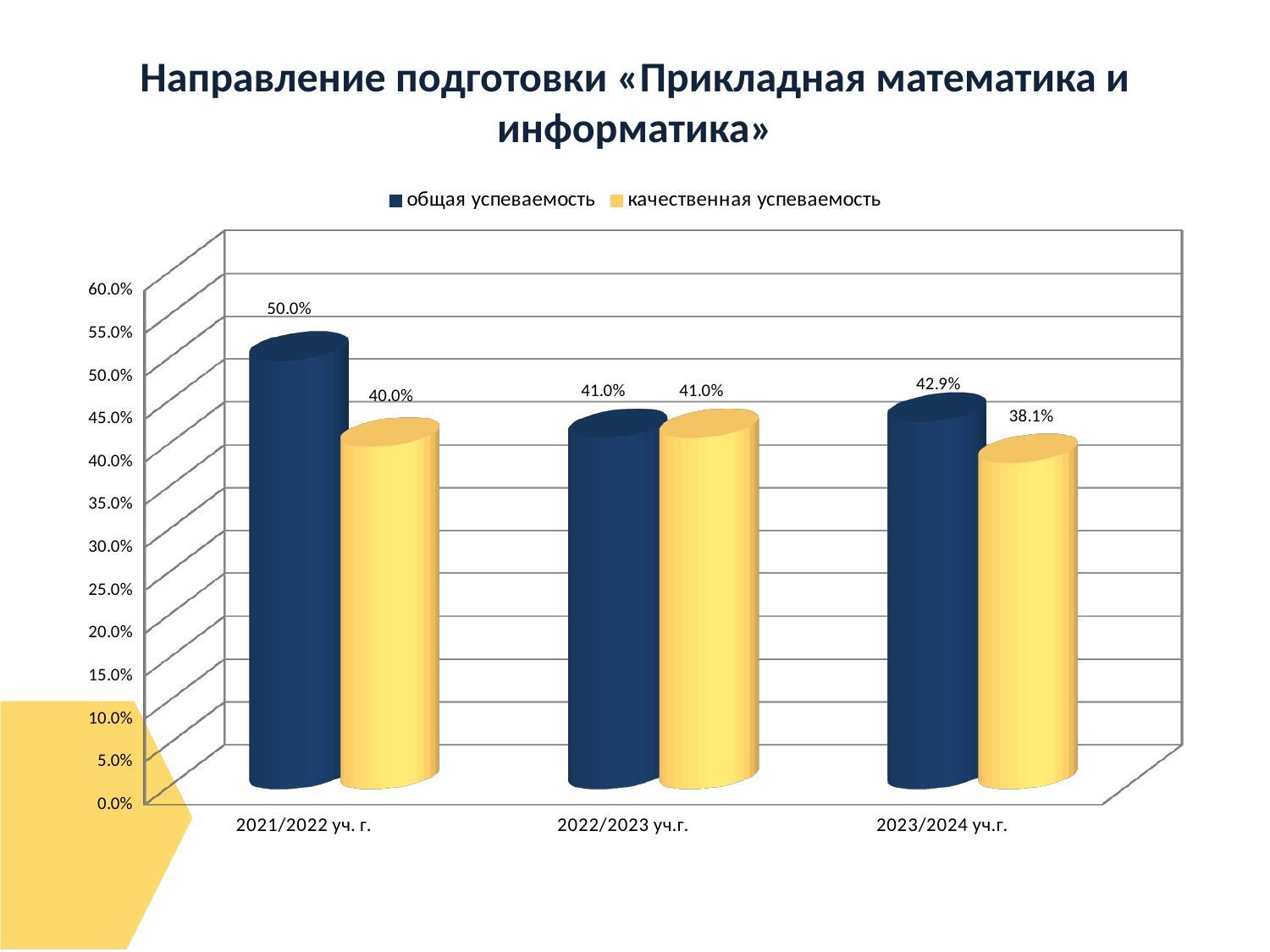
What is the value of общая успеваемость for 2023/2024 уч.г.? 42.9% What is the value of качественная успеваемость for 2023/2024 уч.г.? 38.1% What is the value of общая успеваемость for 2021/2022 уч. г.? 50.0% How many academic years are shown on the x axis? 3 In which academic year is общая успеваемость highest? 2021/2022 уч. г. Which is larger in 2023/2024 уч.г.: общая успеваемость or качественная успеваемость? общая успеваемость In which academic year is качественная успеваемость lowest? 2023/2024 уч.г. What is the value of качественная успеваемость for 2022/2023 уч.г.? 41.0% What is the difference between общая успеваемость and качественная успеваемость in 2021/2022 уч. г.? 10.0% Which colour represents качественная успеваемость in the chart? yellow How many series does the legend list? 2 What kind of chart is shown on the slide? bar chart